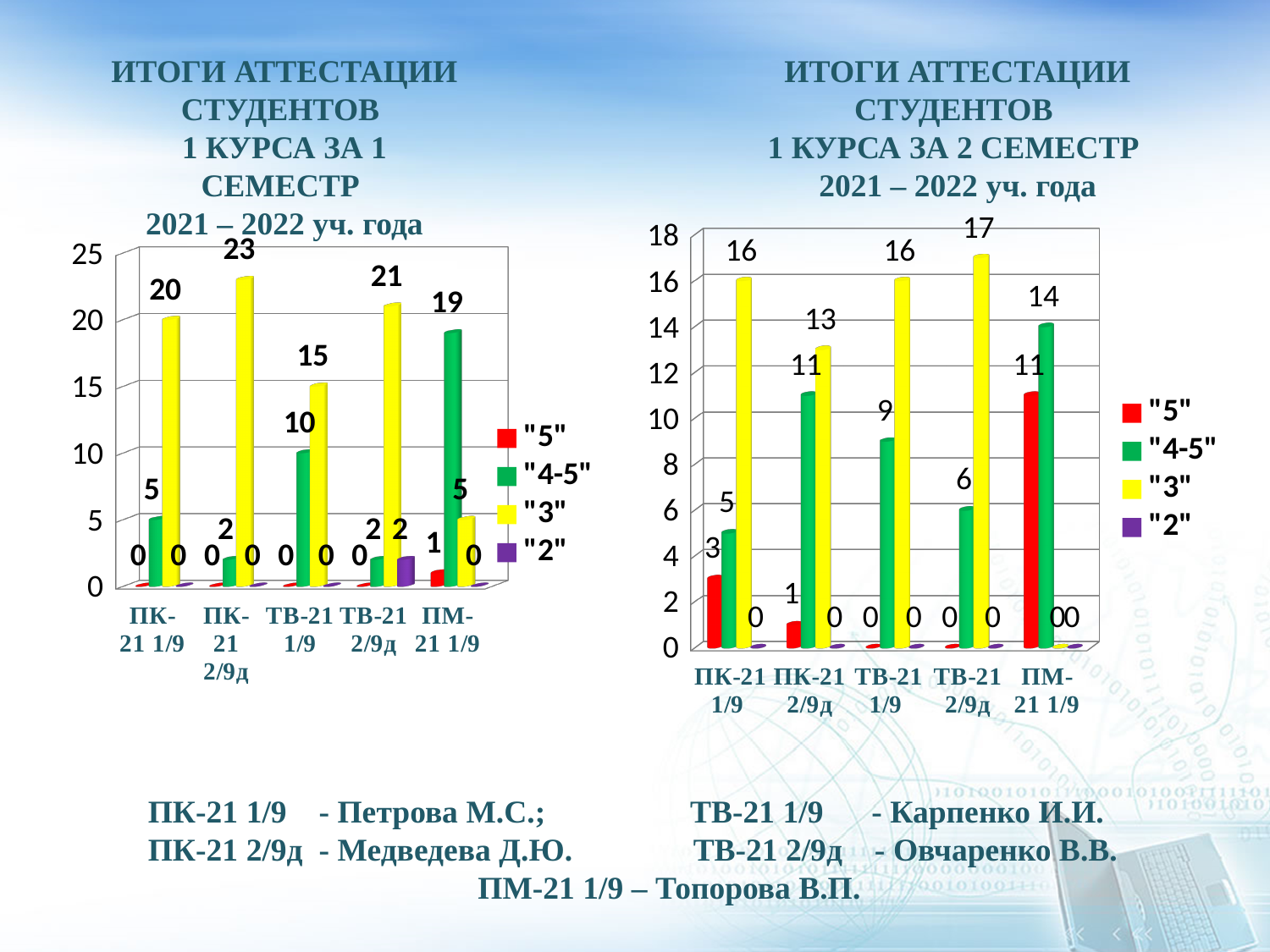
In the right chart (2 семестр), how many categories are shown on the x axis? 5 In the right chart (2 семестр), which is larger for ПК-21 2/9д: "4-5" or "3"? "3" In the right chart (2 семестр), what colour represents the "2" series? Purple In the left chart (1 семестр), what is the value of "4-5" for ПМ-21 1/9? 19 In the left chart (1 семестр), which category has the highest value for "3"? ПК-21 2/9д In the right chart (2 семестр), what is the value of "5" for ПМ-21 1/9? 11 What type of chart is the right chart (2 семестр)? Bar chart In the right chart (2 семестр), which category has the highest value for "3"? ТВ-21 2/9д In the left chart (1 семестр), what is the value of "3" for ПК-21 2/9д? 23 In the left chart (1 семестр), what is the difference between the "3" values for ТВ-21 2/9д and ТВ-21 1/9? 6 In the left chart (1 семестр), how many series does the legend list? 4 In the left chart (1 семестр), what is the total of all four series for ПМ-21 1/9? 25